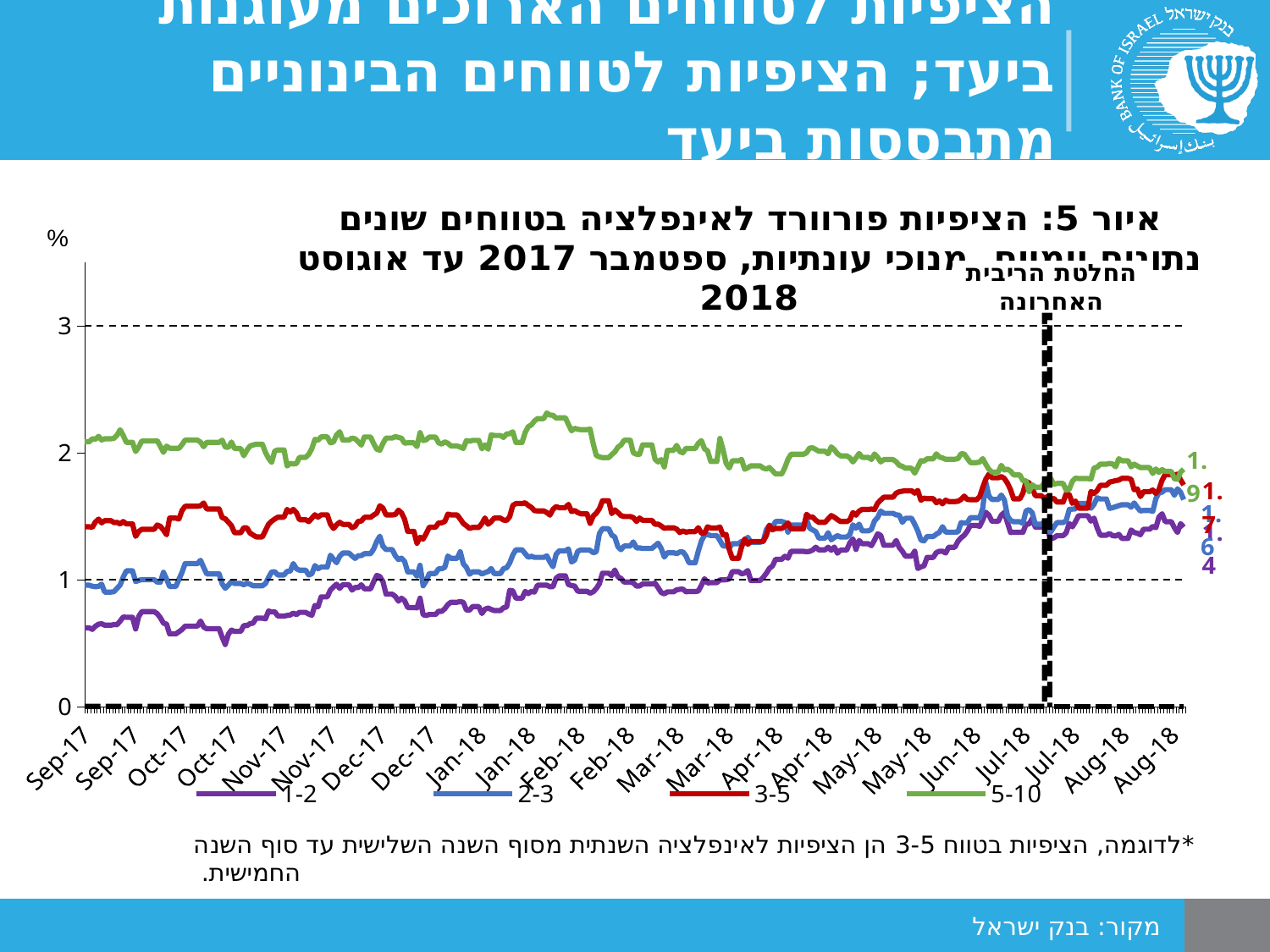
Is the value of the 1-2 series at Sep-17 greater or less than 1? less Does the 1-2 series rise or fall from Sep-17 to Aug-18? rise What unit is shown on the y axis? % At Sep-17, which series has the larger value, 3-5 or 2-3? 3-5 What does the label next to the vertical dashed line say? החלטת הריבית האחרונה Is the value of the 5-10 series at Sep-17 greater or less than 2? greater Which series has the highest values across the whole period? 5-10 How many series does the legend list? 4 Is the value of the 3-5 series at Sep-17 greater or less than 1? greater What kind of chart is shown on the slide? line chart Which series has the lowest value at Sep-17? 1-2